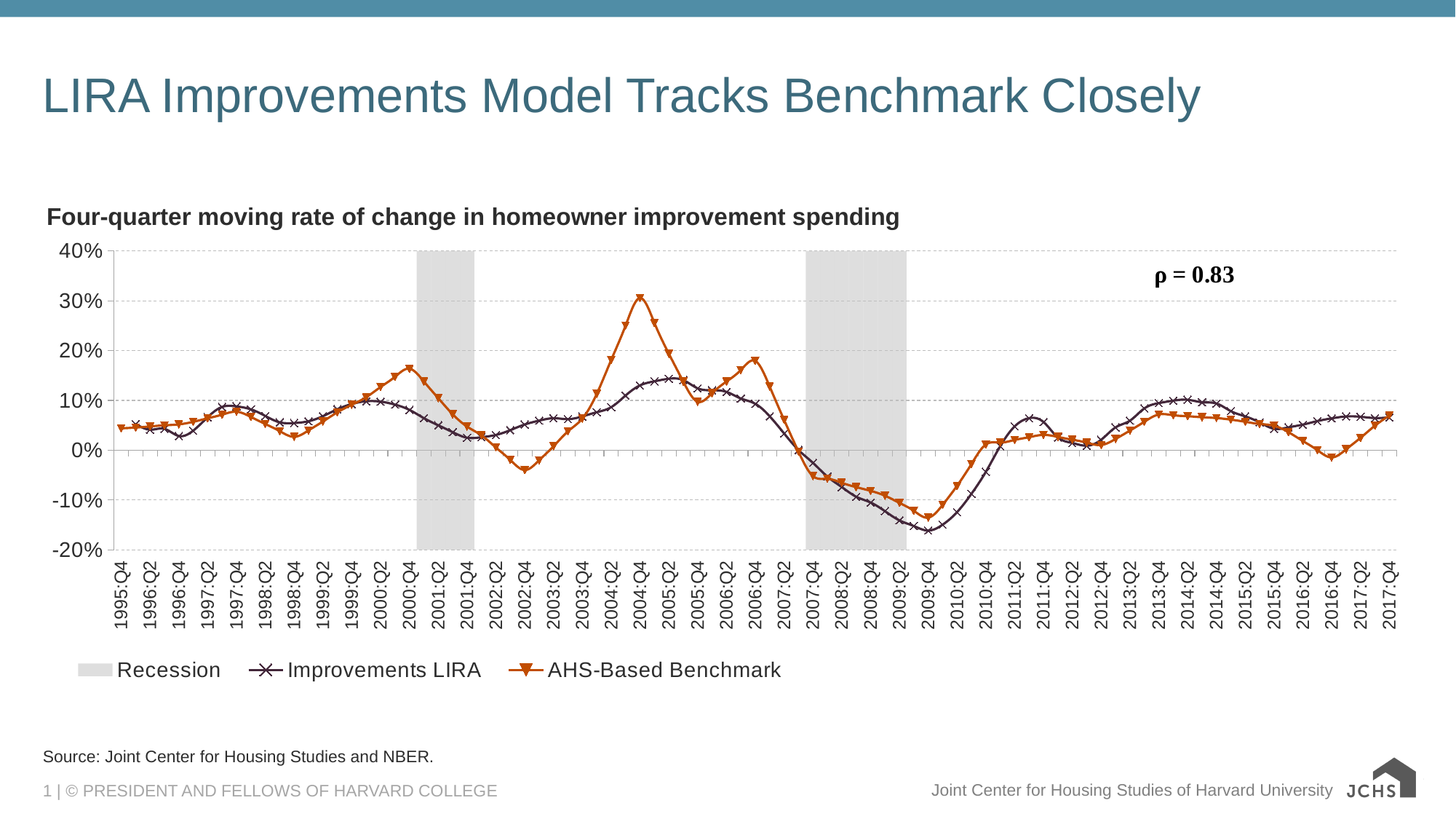
Is the AHS-Based Benchmark value for 2006:Q4 greater or less than 10%? greater Is the AHS-Based Benchmark value for 2002:Q4 greater or less than 0%? less In which quarter does the AHS-Based Benchmark series reach its highest value? 2004:Q4 What correlation coefficient (ρ) is printed on the chart? ρ = 0.83 Does the Improvements LIRA series rise or fall between 2007:Q4 and 2009:Q4? fall At 2004:Q4, which series has the higher value, Improvements LIRA or AHS-Based Benchmark? AHS-Based Benchmark Is the Improvements LIRA value for 2009:Q4 greater or less than -10%? less How many entries does the chart legend list? 3 At 2002:Q4, which series has the higher value, Improvements LIRA or AHS-Based Benchmark? Improvements LIRA In which quarter does the Improvements LIRA series reach its lowest value? 2009:Q4 What kind of chart is shown on the slide? line chart